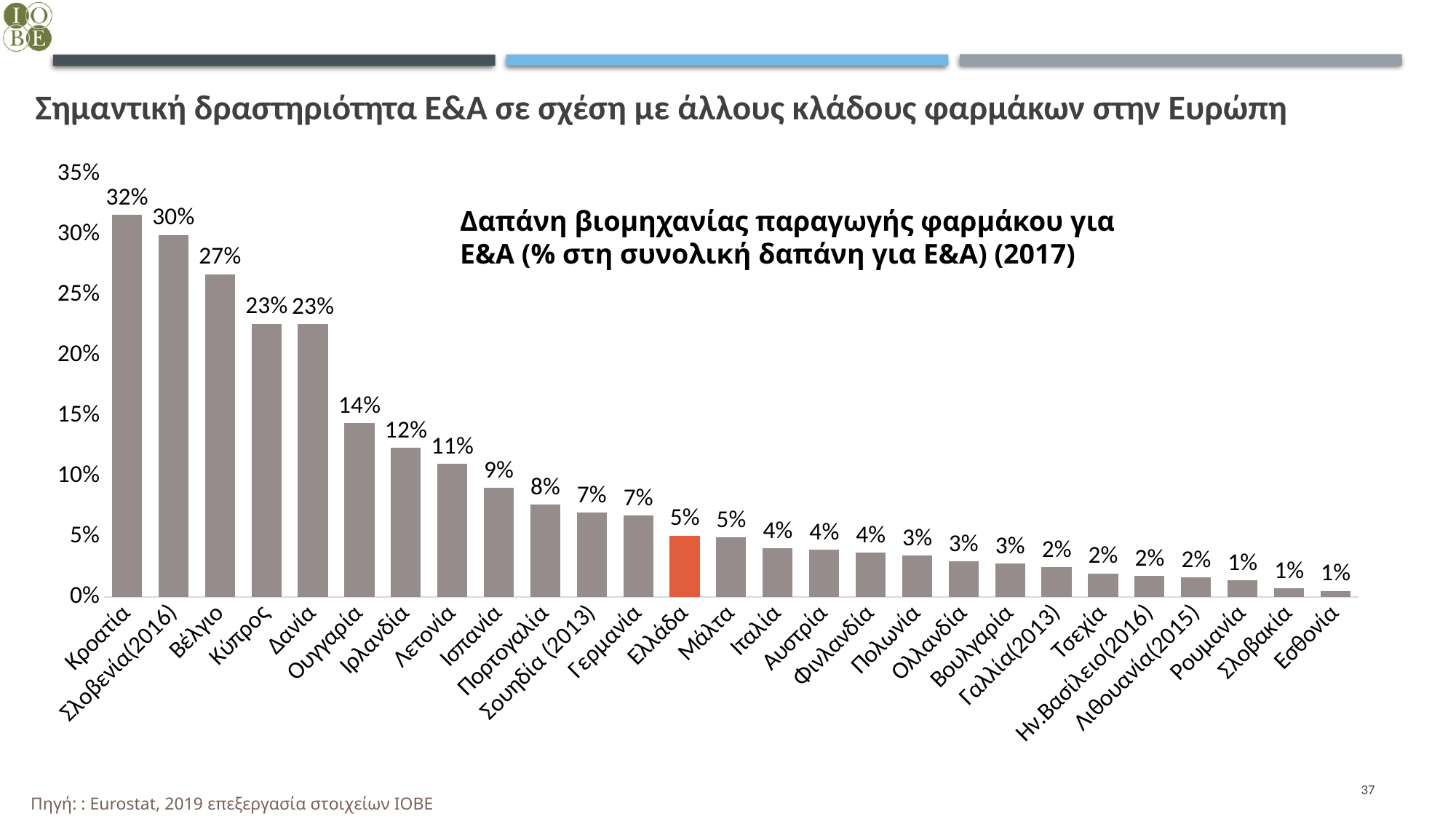
What is the value for Ελλάδα? 5% Is the value for Σλοβενία(2016) greater or less than 25%? greater What is the difference between the values for Κροατία and Βέλγιο? 5% What is the value for Γερμανία? 7% What is the difference between the values for Ελλάδα and Ιρλανδία? 7% How many countries are shown in the chart? 27 What is the value for Ουγγαρία? 14% What is the value for Κροατία? 32% Which bar is highlighted in a different colour (orange) from the others? Ελλάδα Which is larger, the value for Λετονία or the value for Ισπανία? Λετονία Which country has the highest value? Κροατία What kind of chart is shown on the slide? Bar chart